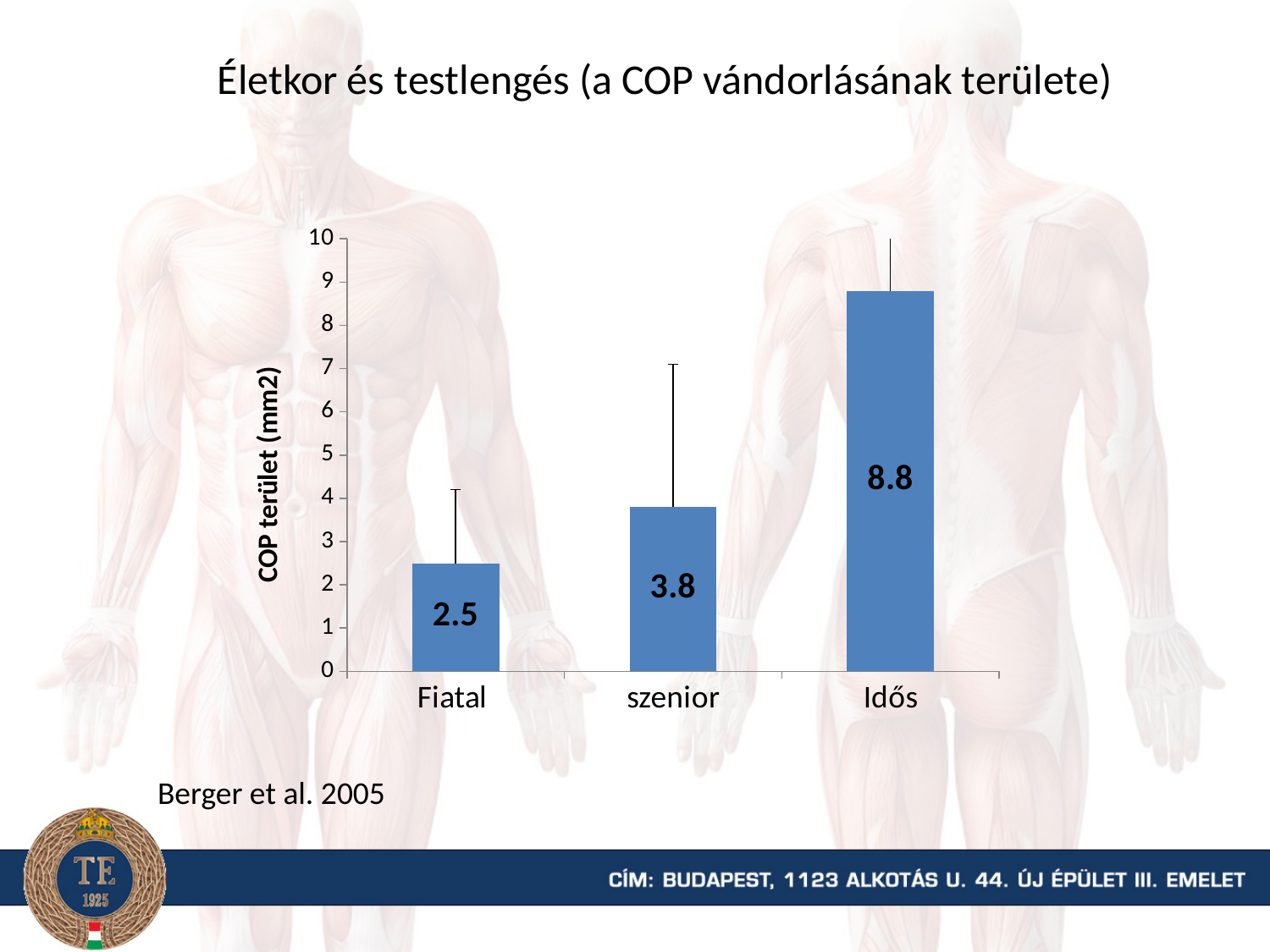
Which is larger, the value for szenior or the value for Idős? Idős What is the COP terület value for Fiatal? 2.5 What is the difference between the values for Idős and Fiatal? 6.3 Which category has the lowest COP terület value? Fiatal How many categories are shown on the x axis? 3 What is the label of the vertical axis? COP terület (mm2) What is the COP terület value for szenior? 3.8 What kind of chart is shown on the slide? bar chart Is the value for Idős greater or less than 8? greater What is the difference between the values for szenior and Fiatal? 1.3 What is the COP terület value for Idős? 8.8 Which category has the highest COP terület value? Idős